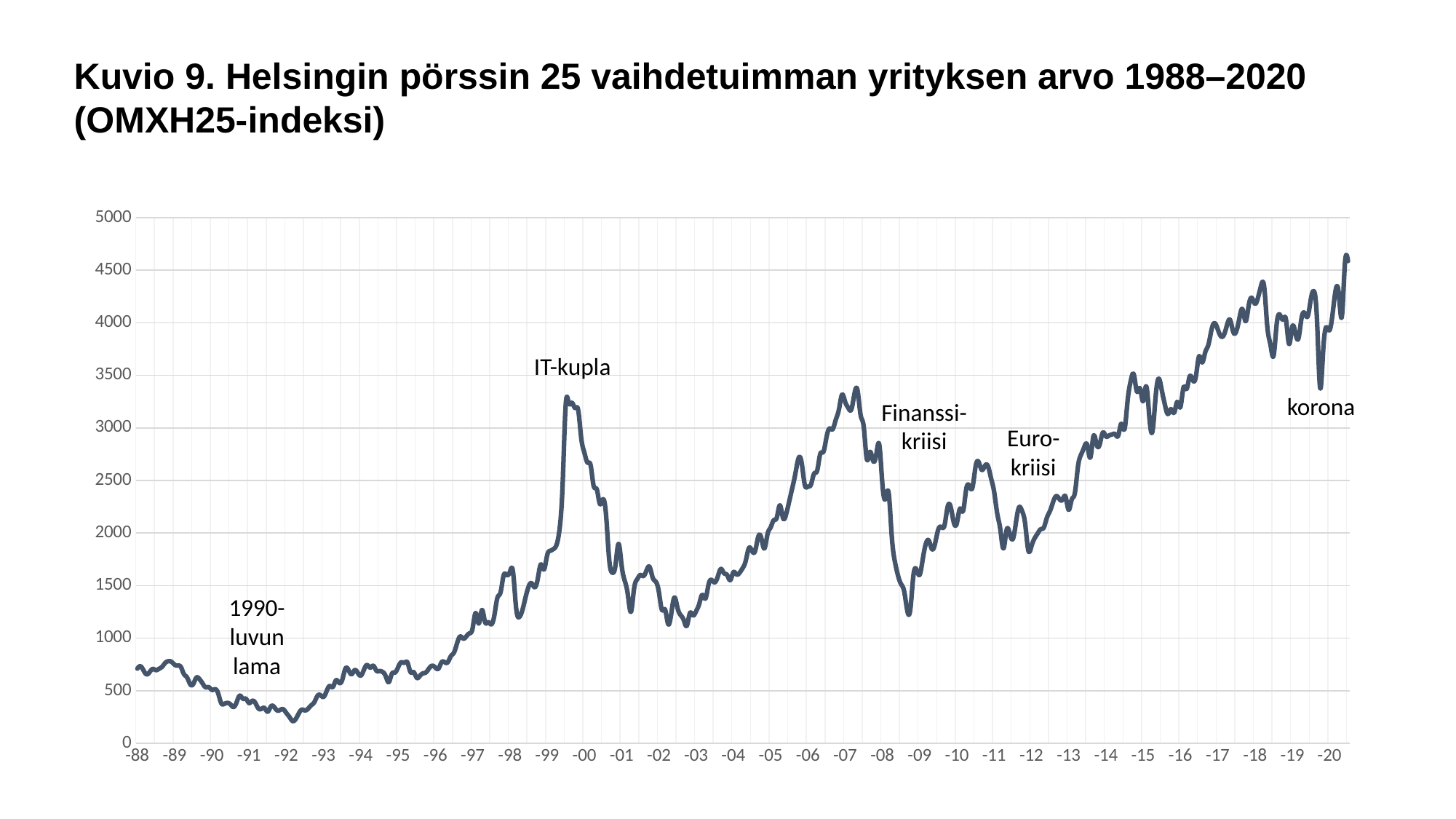
Is the low point of the index in 2009 after the Finanssikriisi greater or less than 1500? less Does the index overall rise or fall from 1988 to 2020? rise How many annotated events are labelled on the chart? 5 Is the low point of the index during the Eurokriisi around 2012 greater or less than 2000? less Is the lowest value of the index around 1992 greater or less than 500? less What kind of chart is shown on the slide? line chart Which event label is placed next to the peak around the year 2000? IT-kupla How many lines (series) are plotted on the chart? 1 In which year does the index reach its lowest value? 1992 What is the title of the chart? Kuvio 9. Helsingin pörssin 25 vaihdetuimman yrityksen arvo 1988–2020 (OMXH25-indeksi)